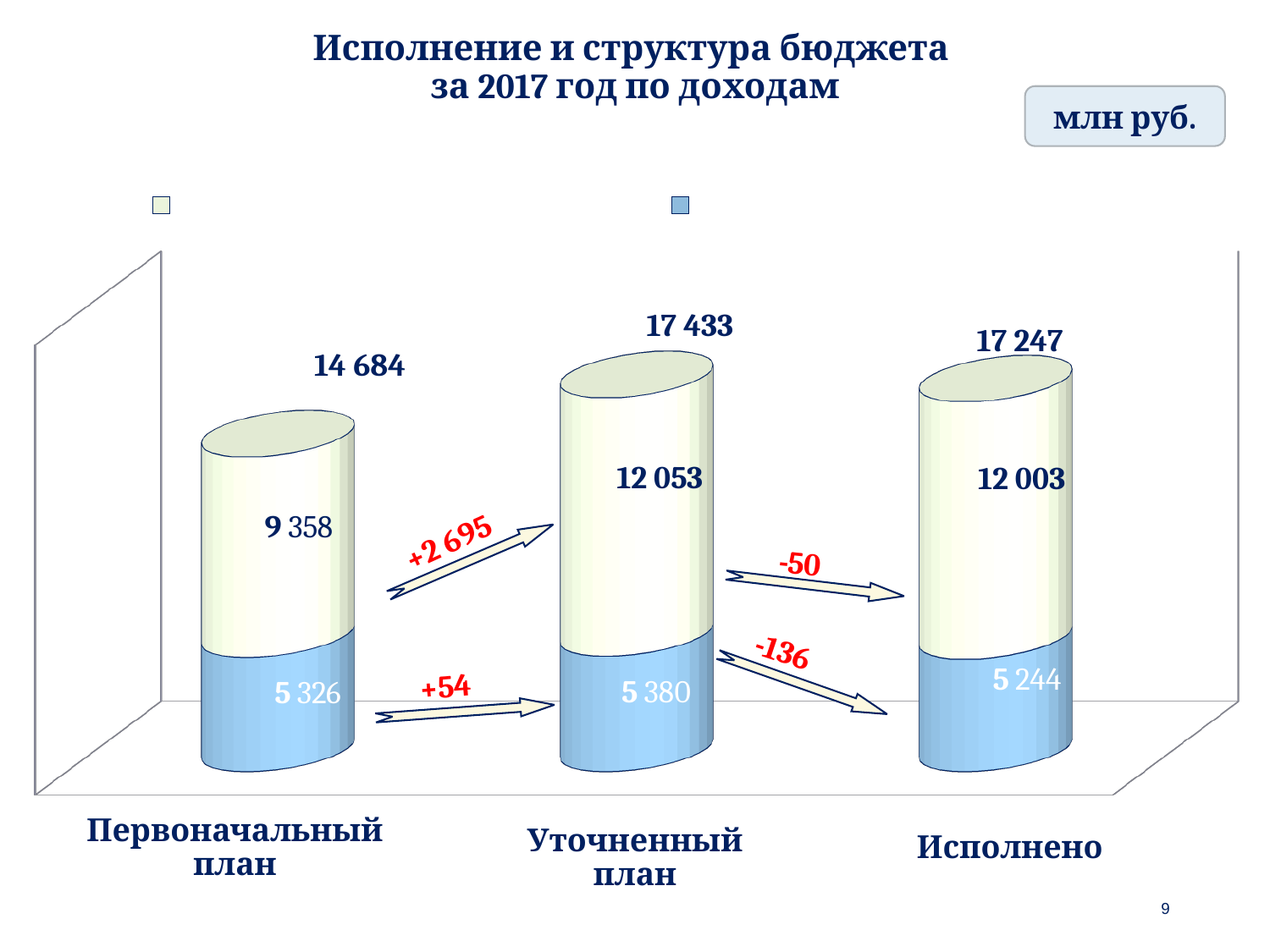
How many series does the legend list? 2 What is the total value shown above the bar for Уточненный план? 17 433 What is the total of the stacked bar for Первоначальный план? 14 684 Which category has the highest total value? Уточненный план What kind of chart is shown on the slide? Stacked bar chart Which is larger, the upper (light) segment for Уточненный план or for Исполнено? Уточненный план What is the value of the blue (lower) segment for Исполнено? 5 244 What is the value of the upper (light) segment for Первоначальный план? 9 358 What change is shown by the arrow between the upper segments of Первоначальный план and Уточненный план? +2 695 Which category has the lowest total value? Первоначальный план What is the difference between the total for Уточненный план and the total for Исполнено? 186 How many categories are shown on the x axis? 3